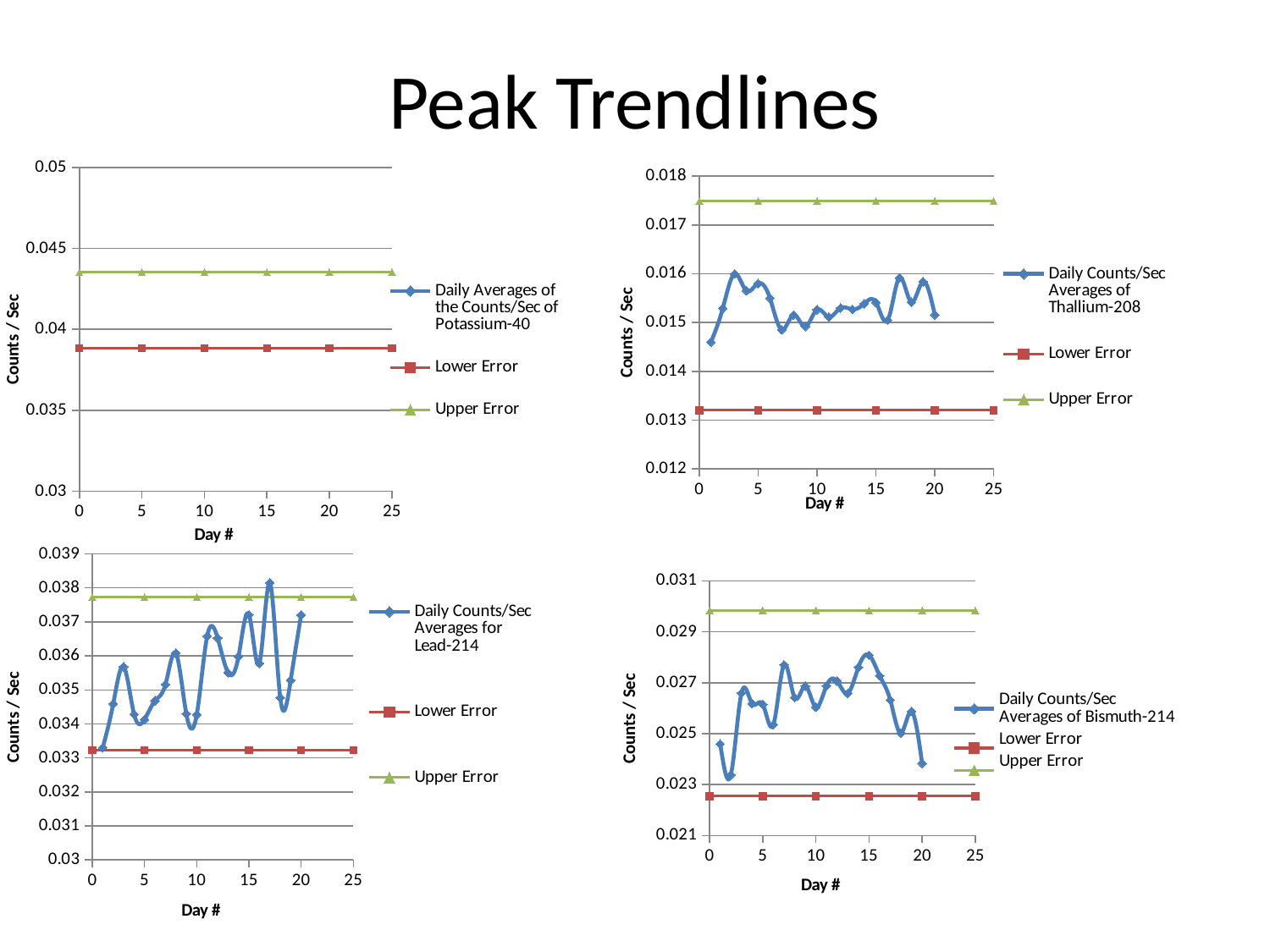
In the top-left chart (Potassium-40), is the Upper Error value greater or less than 0.04? greater In the top-left chart (Potassium-40), is the Lower Error value greater or less than 0.04? less In the bottom-left chart (Lead-214), is the Lower Error value greater or less than 0.034? less How many charts are shown on the slide? 4 In the top-left chart (Potassium-40), how many series does the legend list? 3 In the bottom-left chart, what is the legend label of the blue series? Daily Counts/Sec Averages for Lead-214 What kind of chart is the top-left chart (Potassium-40)? Line chart